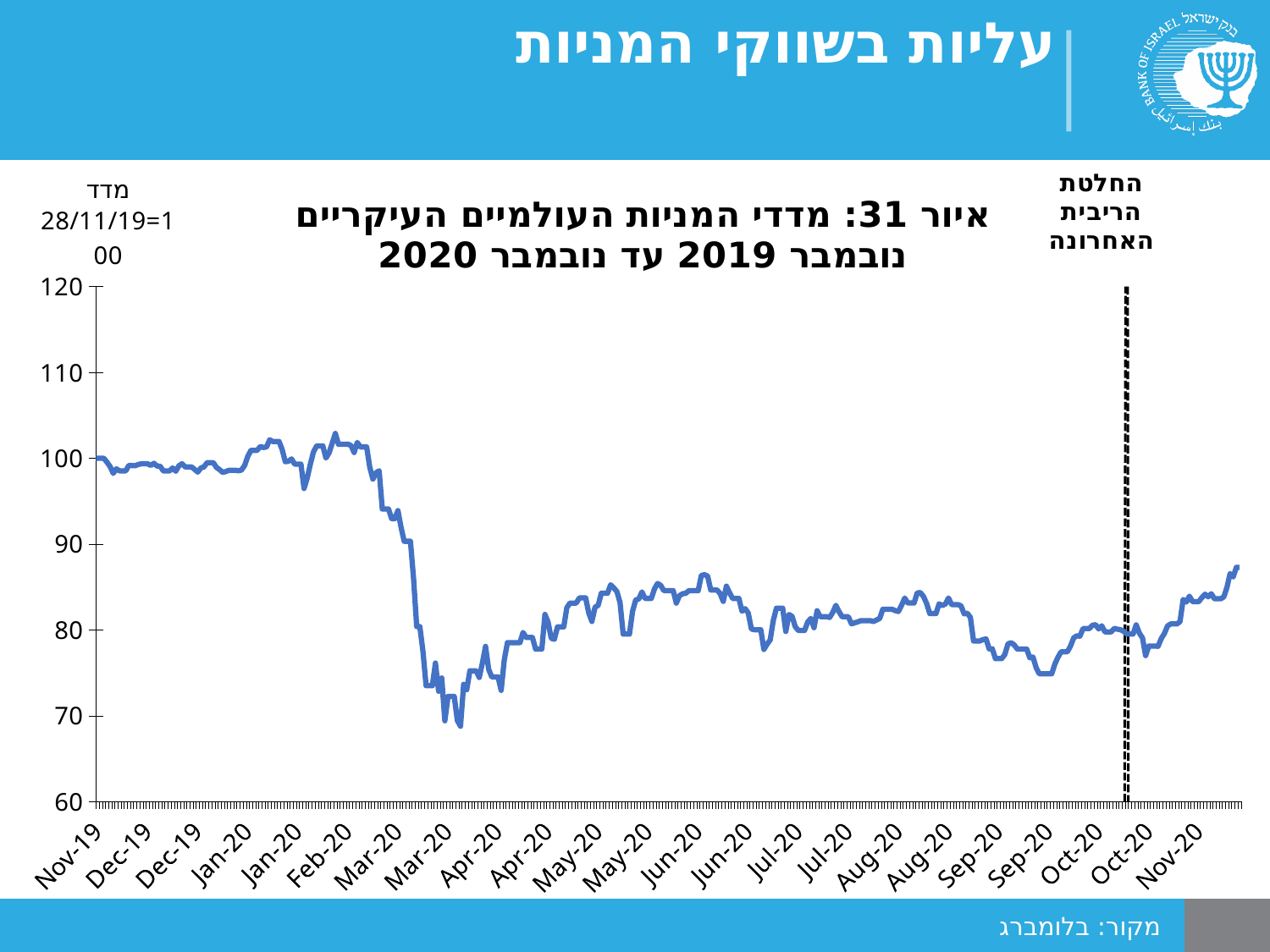
Is the value of the index around Sep-20 greater or less than 90? less Is the value of the index at the end of the series (Nov-20) greater or less than 90? less Is the lowest point of the index, reached around Mar-20, greater or less than 80? less Is the index value at Nov-19 higher or lower than the index value at Nov-20? higher What is the title of the chart? איור 31: מדדי המניות העולמיים העיקריים נובמבר 2019 עד נובמבר 2020 What is the source cited at the bottom of the slide? בלומברג What kind of chart is shown on the slide? line chart Does the index rise or fall between Feb-20 and the end of Mar-20? fall Does the index rise or fall between Sep-20 and Nov-20? rise How many lines (data series) are plotted on the chart? 1